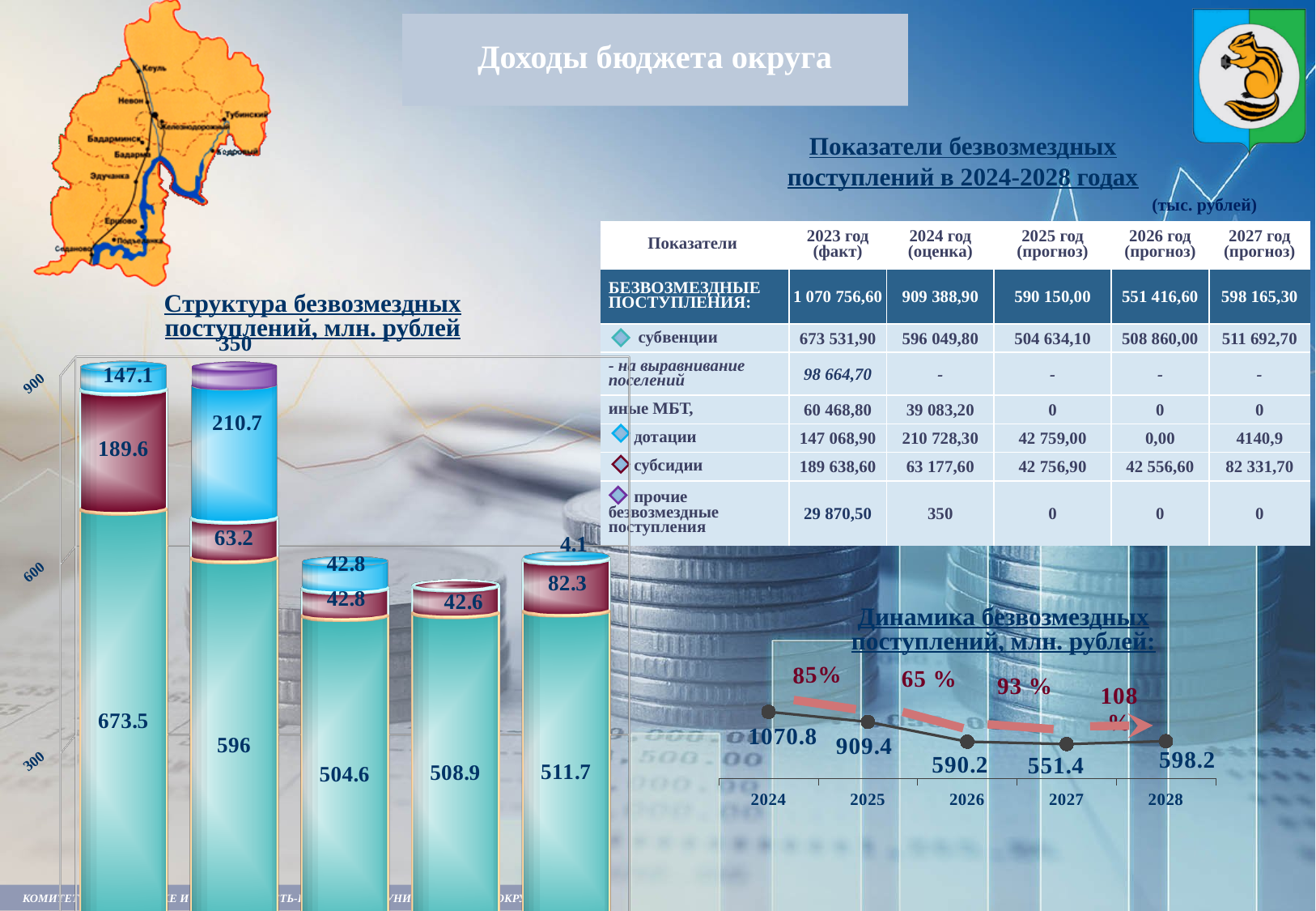
In the chart 'Динамика безвозмездных поступлений, млн. рублей', which year has the highest value? 2024 In the chart 'Динамика безвозмездных поступлений, млн. рублей', which is larger: the value for 2027 or for 2028? 2028 In the chart 'Динамика безвозмездных поступлений, млн. рублей', do the values rise or fall from 2024 to 2027? fall In the chart 'Динамика безвозмездных поступлений, млн. рублей', what is the difference between the values for 2024 and 2025? 161.4 In the chart 'Динамика безвозмездных поступлений, млн. рублей', which year has the lowest value? 2027 In the chart 'Динамика безвозмездных поступлений, млн. рублей', what is the value for 2026? 590.2 In the chart 'Структура безвозмездных поступлений, млн. рублей', what is the total of the third bar from the left (504.6, 42.8 and 42.8)? 590.2 How many data points are plotted in the chart 'Динамика безвозмездных поступлений, млн. рублей'? 5 How many bars are there in the chart 'Структура безвозмездных поступлений, млн. рублей'? 5 What kind of chart is 'Динамика безвозмездных поступлений, млн. рублей'? line chart What kind of chart is 'Структура безвозмездных поступлений, млн. рублей'? bar chart In the chart 'Динамика безвозмездных поступлений, млн. рублей', what percentage is shown between 2024 and 2025? 85%